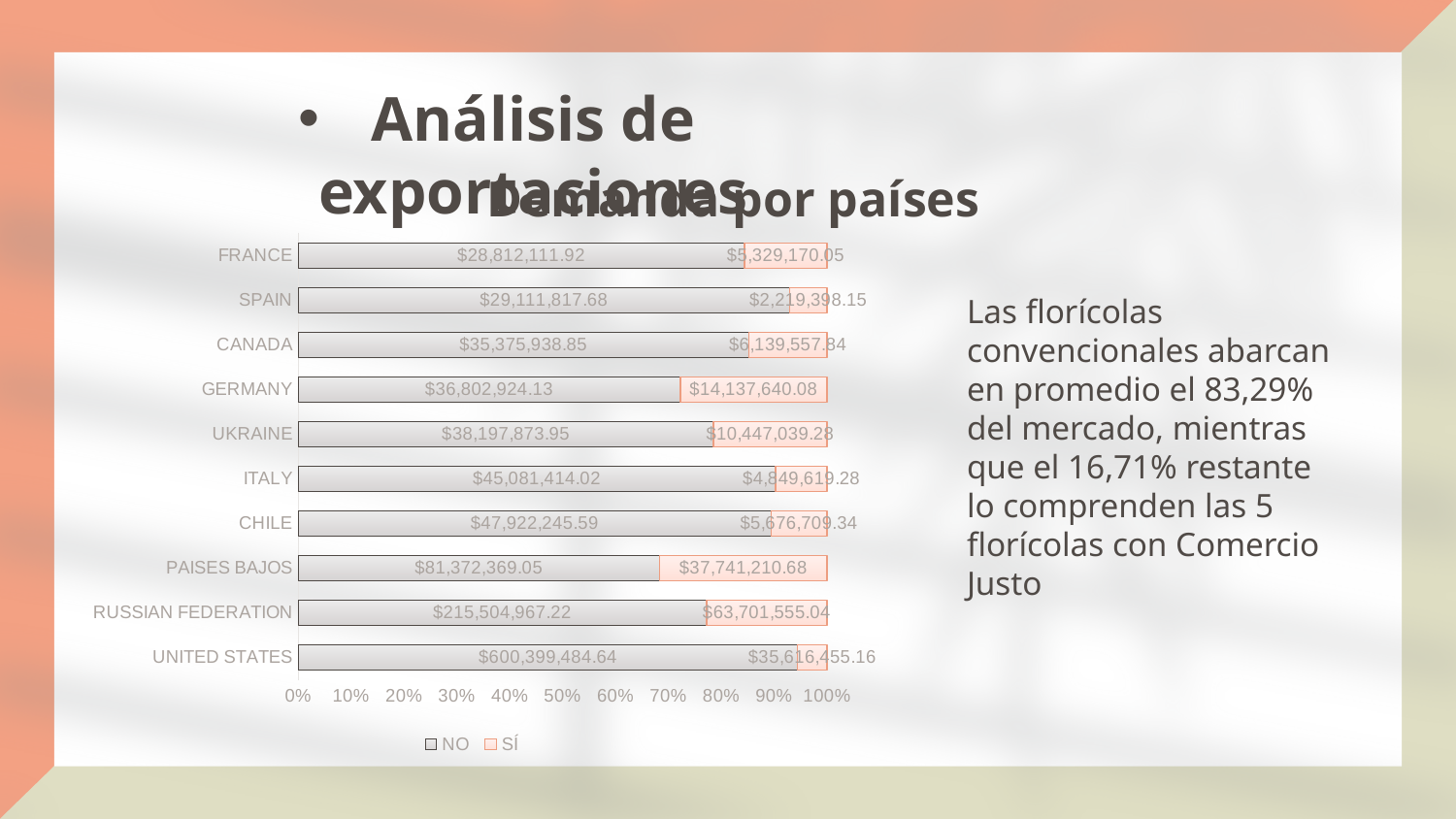
What is the total of the NO and SÍ values for RUSSIAN FEDERATION? $279,206,522.26 What is the SÍ value for GERMANY? $14,137,640.08 How many countries are listed on the chart? 10 Which country has the highest NO value? UNITED STATES What is the NO value for UNITED STATES? $600,399,484.64 Which country has the lowest NO value? FRANCE How many series does the legend list? 2 What type of chart is shown on the slide? Stacked bar chart Is the NO share of the GERMANY bar greater or less than 80%? less What is the NO value for PAISES BAJOS? $81,372,369.05 What is the difference between the NO and SÍ values for GERMANY? $22,665,284.05 What are the two series named in the legend? NO and SÍ